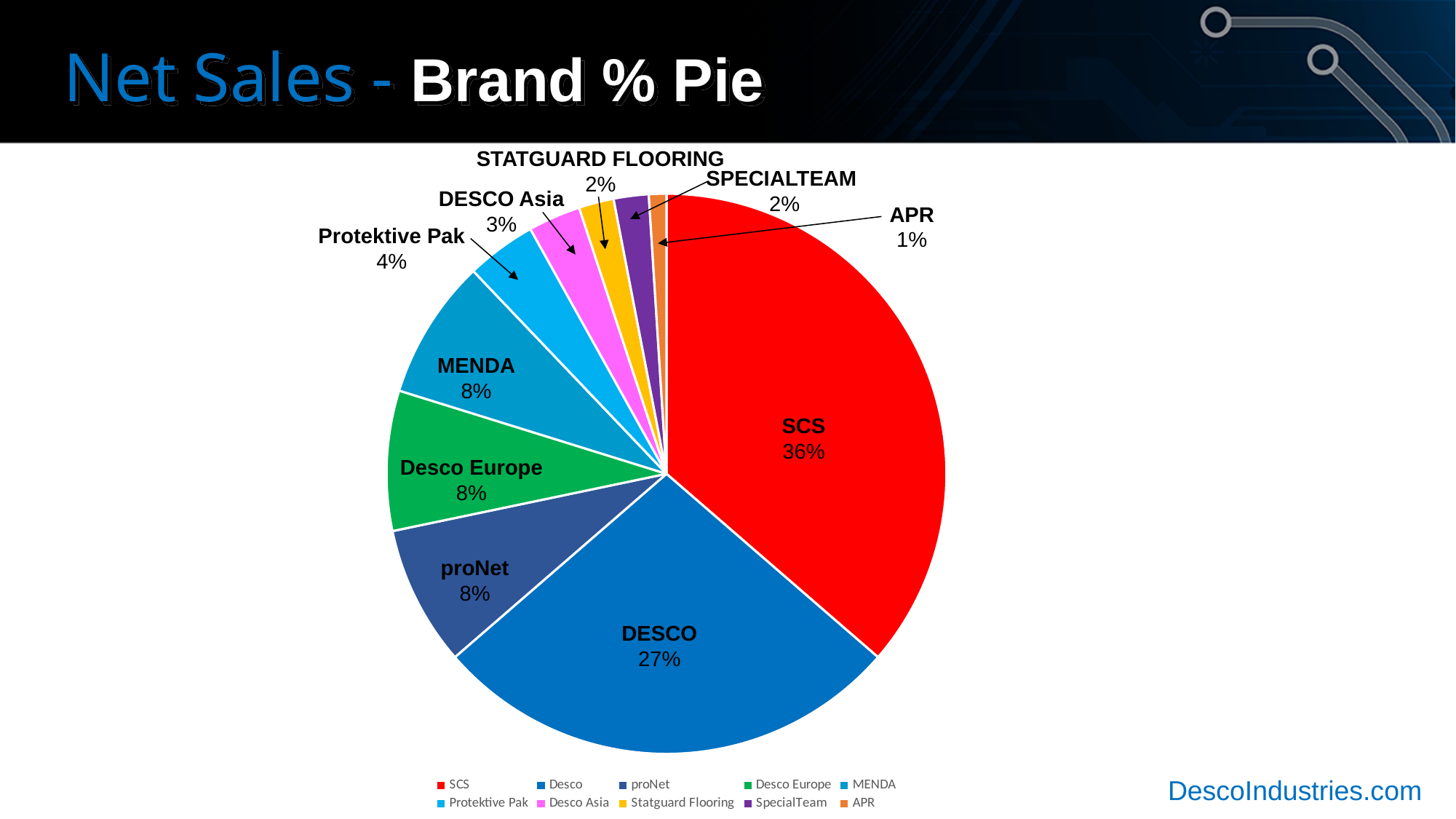
What percentage is shown for DESCO? 27% What share of net sales does SCS account for? 36% What percentage is shown for MENDA? 8% Which is larger, the share for MENDA or the share for Protektive Pak? MENDA Which brand has the largest slice of the pie? SCS What kind of chart is shown on the slide? Pie chart Which brand has the smallest slice of the pie? APR What is the difference in percentage points between SCS and DESCO? 9 What percentage is shown for DESCO Asia? 3% How many brands are shown in the pie chart? 10 What colour is the SCS slice? Red What percentage is shown for Protektive Pak? 4%